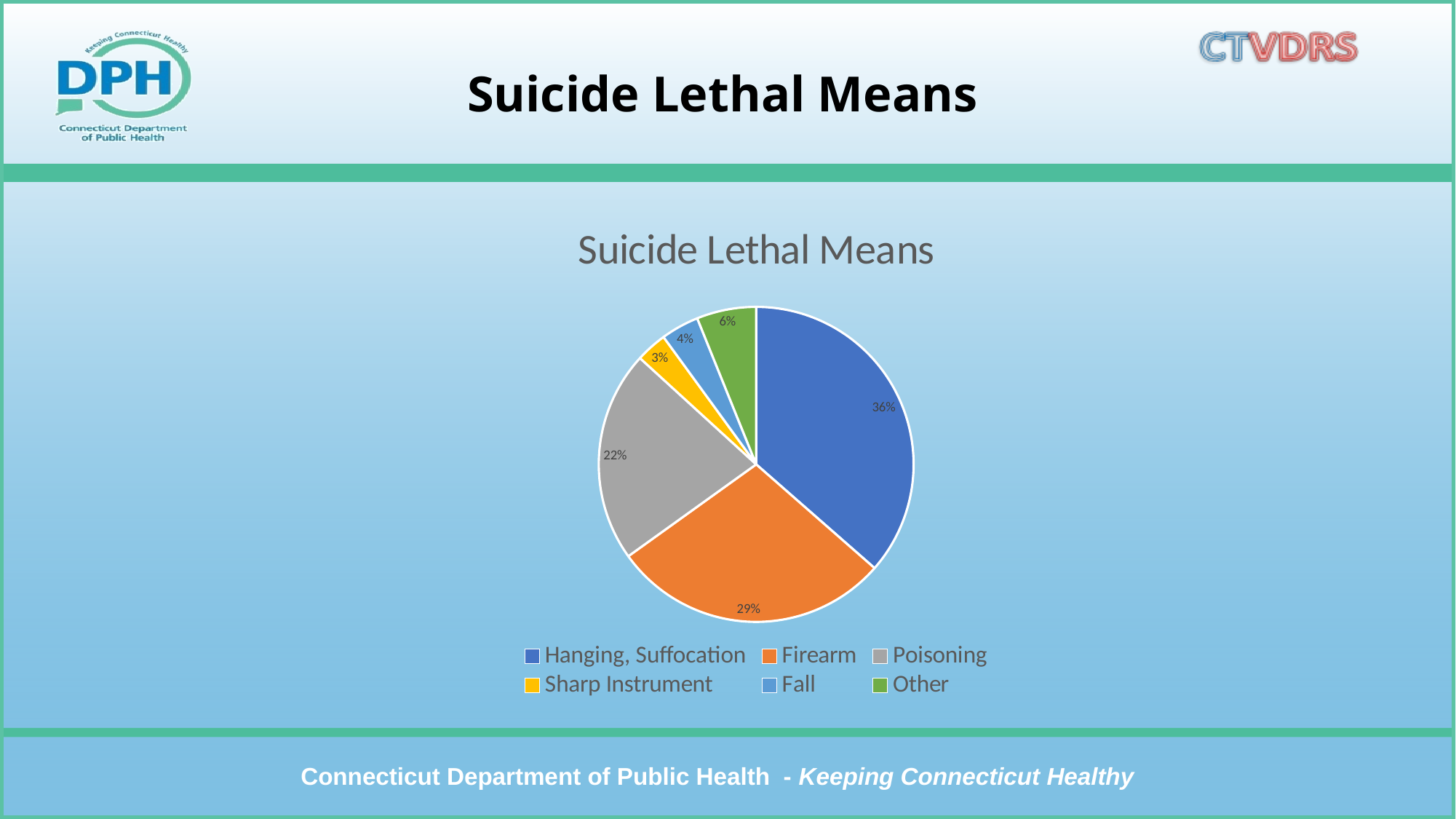
Which is larger, the share for Other or the share for Fall? Other What type of chart is shown on the slide? Pie chart What percentage of the pie is Sharp Instrument? 3% What percentage of the pie is Poisoning? 22% What percentage of the pie is Fall? 4% What percentage of the pie is Firearm? 29% What is the difference in percentage points between Hanging, Suffocation and Firearm? 7 Which category has the smallest share of the pie? Sharp Instrument How many categories does the legend list? 6 Which category has the largest share of the pie? Hanging, Suffocation What is the title of the chart? Suicide Lethal Means What percentage of the pie is Hanging, Suffocation? 36%